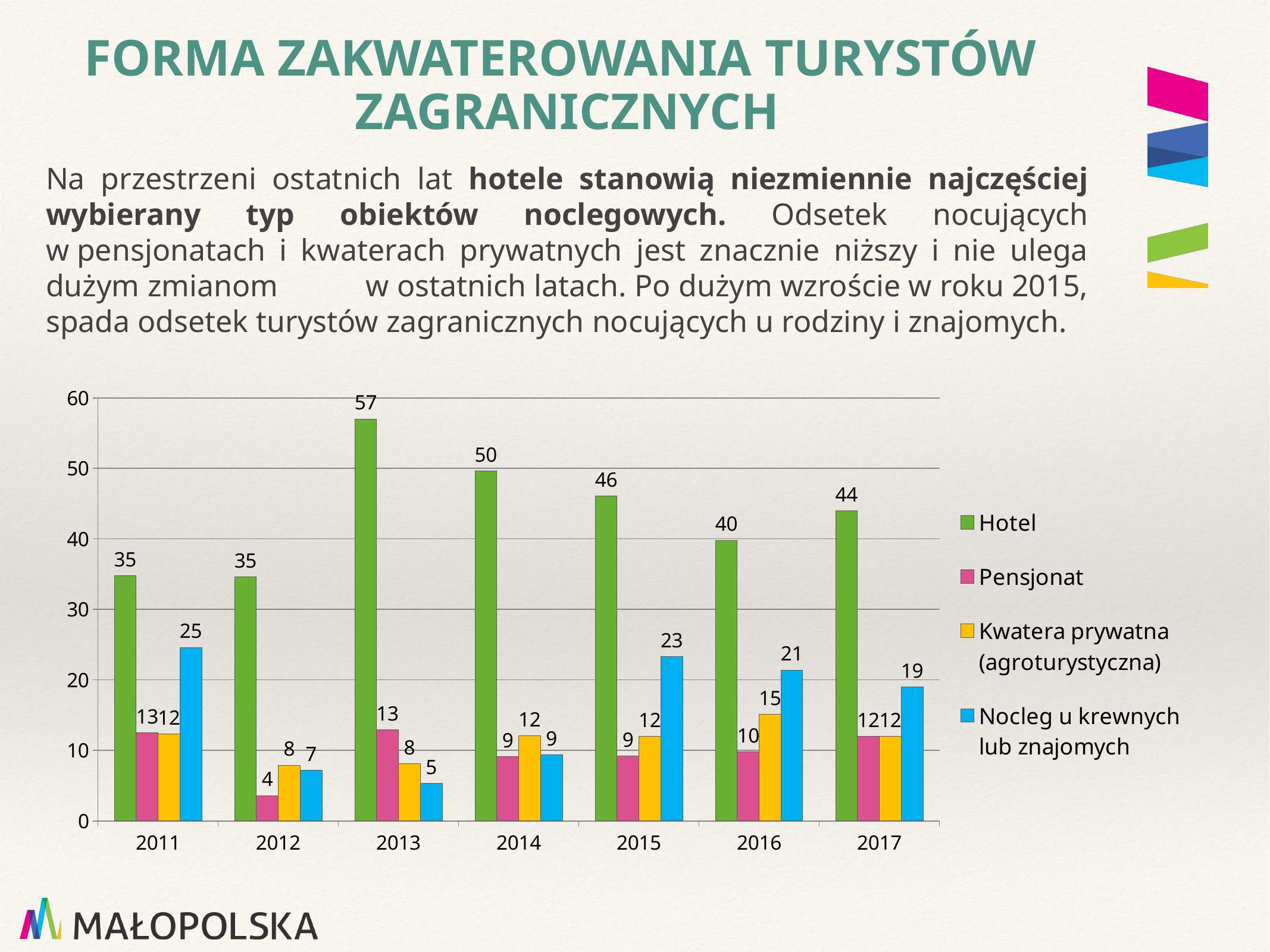
What is the value for Nocleg u krewnych lub znajomych in 2015? 23 In which year is the Hotel value highest? 2013 What kind of chart is shown on the slide? Bar chart In which year is the Nocleg u krewnych lub znajomych value lowest? 2013 What is the value for Hotel in 2013? 57 How many years are shown on the x axis? 7 What is the difference between the Hotel values in 2013 and 2014? 7 How many series does the legend list? 4 What is the value for Pensjonat in 2012? 4 What is the value for Kwatera prywatna (agroturystyczna) in 2016? 15 Which is larger: Nocleg u krewnych lub znajomych in 2011 or in 2017? 2011 Which colour represents the Hotel series in the chart? Green